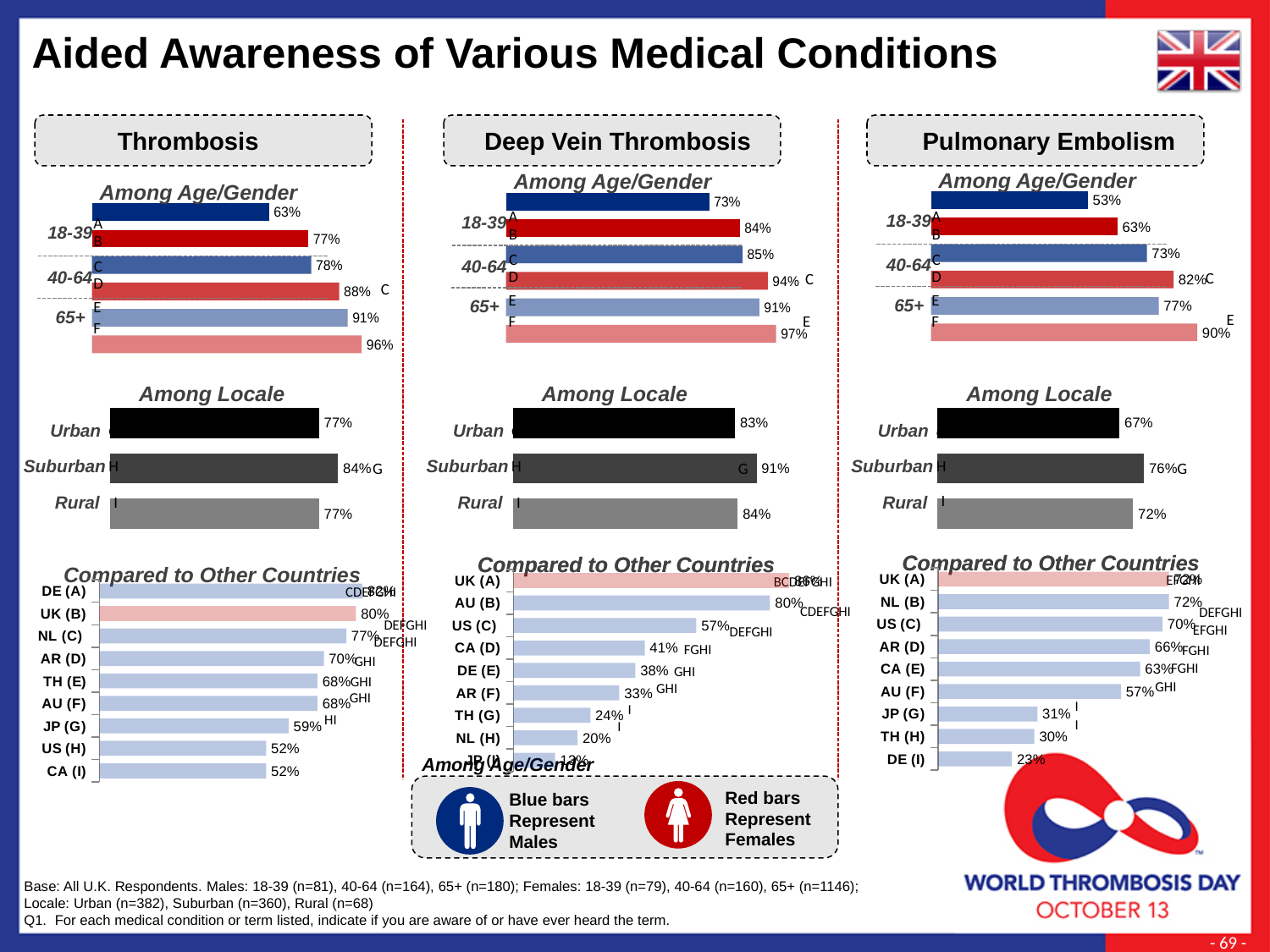
In the Deep Vein Thrombosis 'Compared to Other Countries' chart, which is larger, CA (D) or DE (E)? CA (D) In the Pulmonary Embolism 'Compared to Other Countries' chart, which country has the lowest value? DE (I) In the Deep Vein Thrombosis 'Compared to Other Countries' chart, what is the value for US (C)? 57% In the Thrombosis 'Among Age/Gender' chart, what is the value for bar F (females 65+)? 96% In the Thrombosis 'Compared to Other Countries' chart, how many countries are listed? 9 In the Thrombosis 'Among Age/Gender' chart, do the values rise or fall from bar A to bar F? rise In the Deep Vein Thrombosis 'Among Age/Gender' chart, what is the value for bar D (females 40-64)? 94% In the Thrombosis 'Among Locale' chart, what is the value for Suburban? 84% In the Deep Vein Thrombosis 'Among Locale' chart, which locale has the highest value? Suburban In the Pulmonary Embolism 'Among Locale' chart, what is the difference between Suburban and Urban? 9% According to the legend at the bottom of the slide, what do the red bars represent? Females In the Pulmonary Embolism 'Among Age/Gender' chart, what is the value for bar A (males 18-39)? 53%